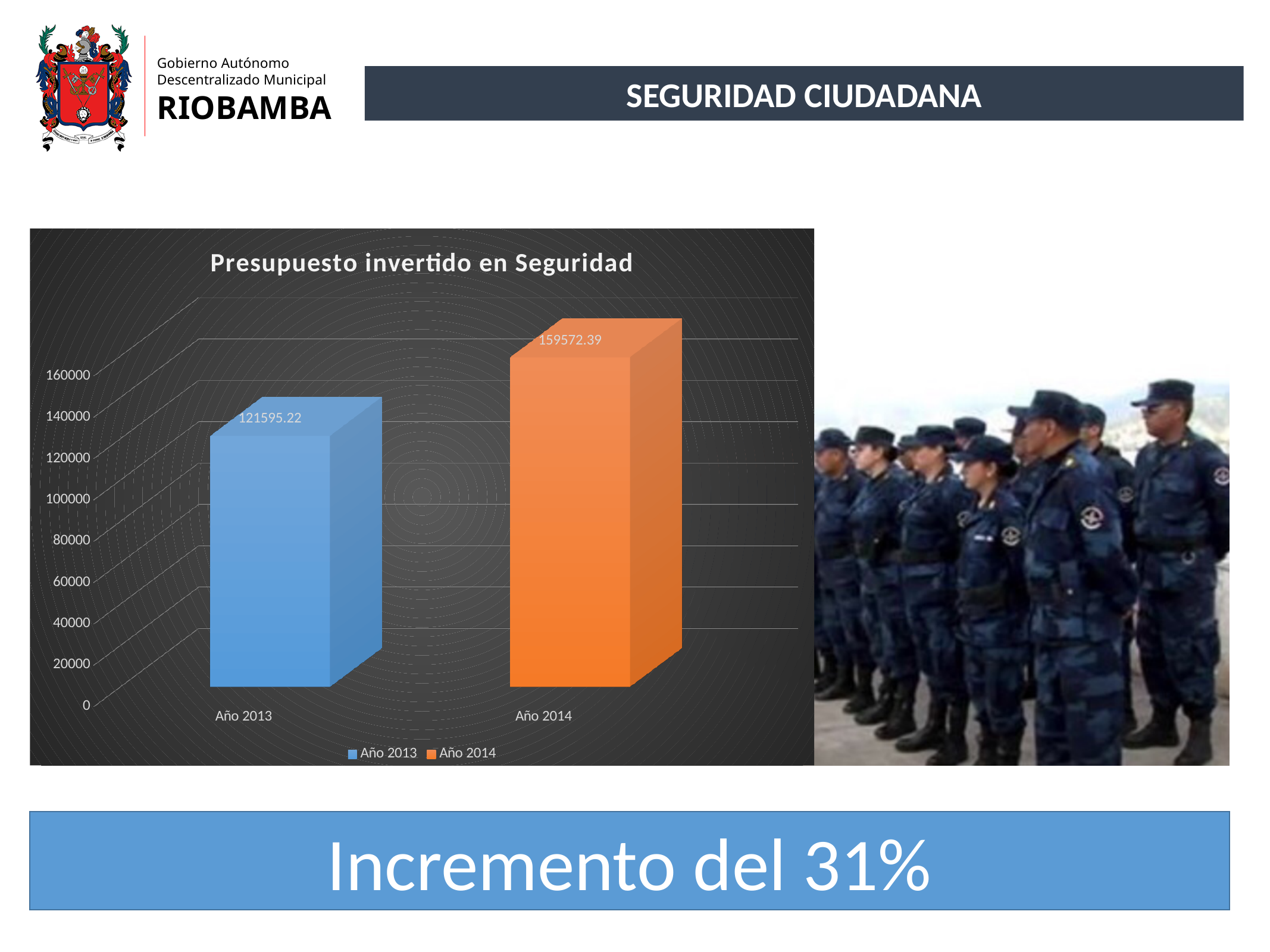
What is the value for Año 2014 in the chart? 159572.39 Is the value for Año 2013 larger or smaller than the value for Año 2014? smaller Which year has the higher budget invested in security? Año 2014 How many bars are plotted in the chart? 2 What kind of chart is shown on the slide? bar chart What is the difference between the values for Año 2014 and Año 2013? 37977.17 What is the value for Año 2013 in the chart? 121595.22 Is the value for Año 2013 greater or less than 140000? less How many entries does the legend list? 2 Is the value for Año 2014 greater or less than 140000? greater Which year has the lower budget invested in security? Año 2013 What is the title of the chart? Presupuesto invertido en Seguridad